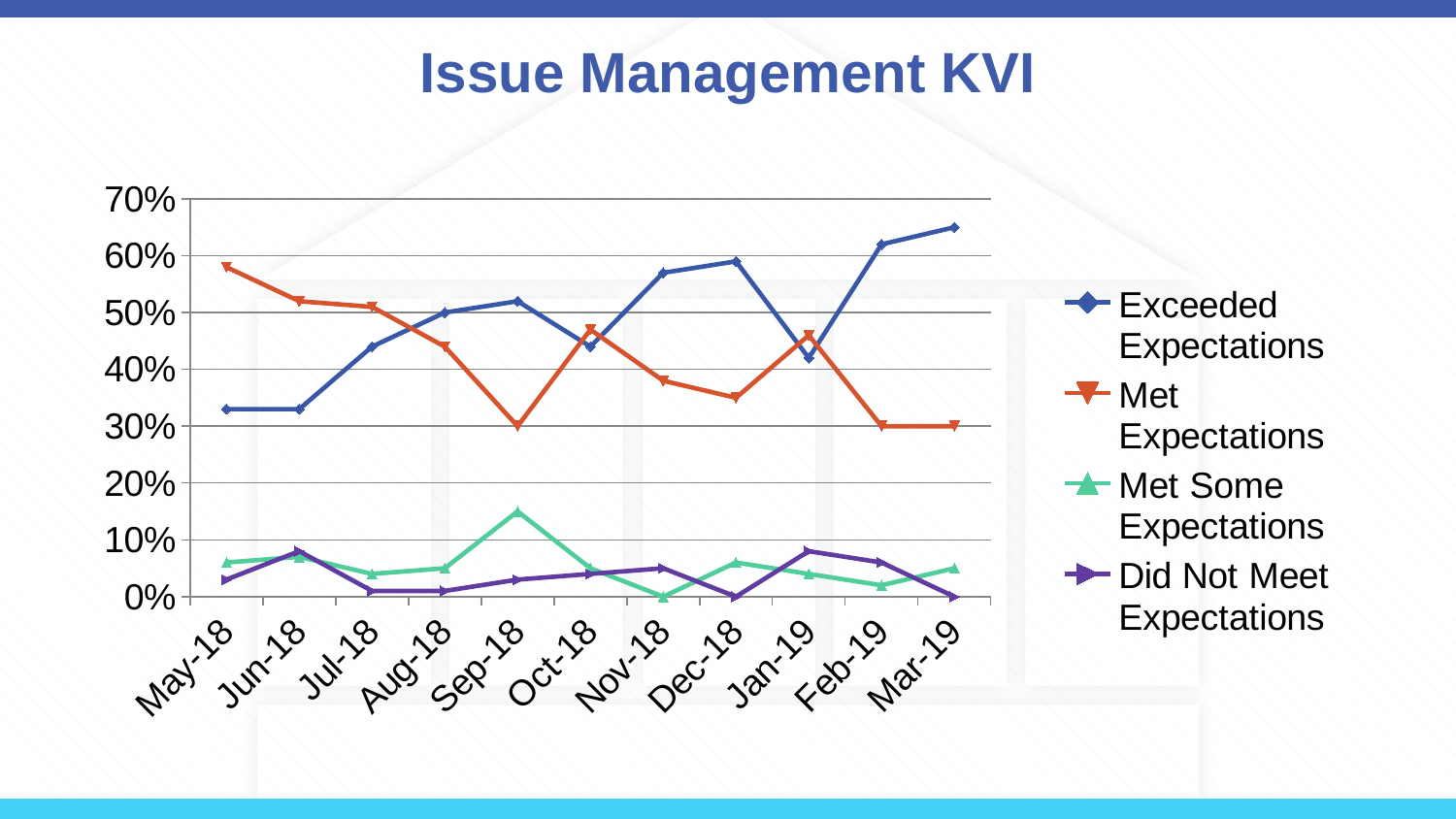
Is the value for Exceeded Expectations in Mar-19 greater or less than 60%? greater How many series does the legend list? 4 What is the value for Met Some Expectations in Nov-18? 0% In Mar-19, which is larger: Exceeded Expectations or Met Expectations? Exceeded Expectations What is the value for Met Expectations in Sep-18? 30% How many months are plotted along the x axis? 11 Does the Met Expectations line generally rise or fall from May-18 to Mar-19? fall In which month is Exceeded Expectations at its highest? Mar-19 What is the value for Exceeded Expectations in Aug-18? 50% In which month is Met Expectations at its highest? May-18 What kind of chart is shown on the slide? line chart Is the value for Met Expectations in May-18 greater or less than 50%? greater